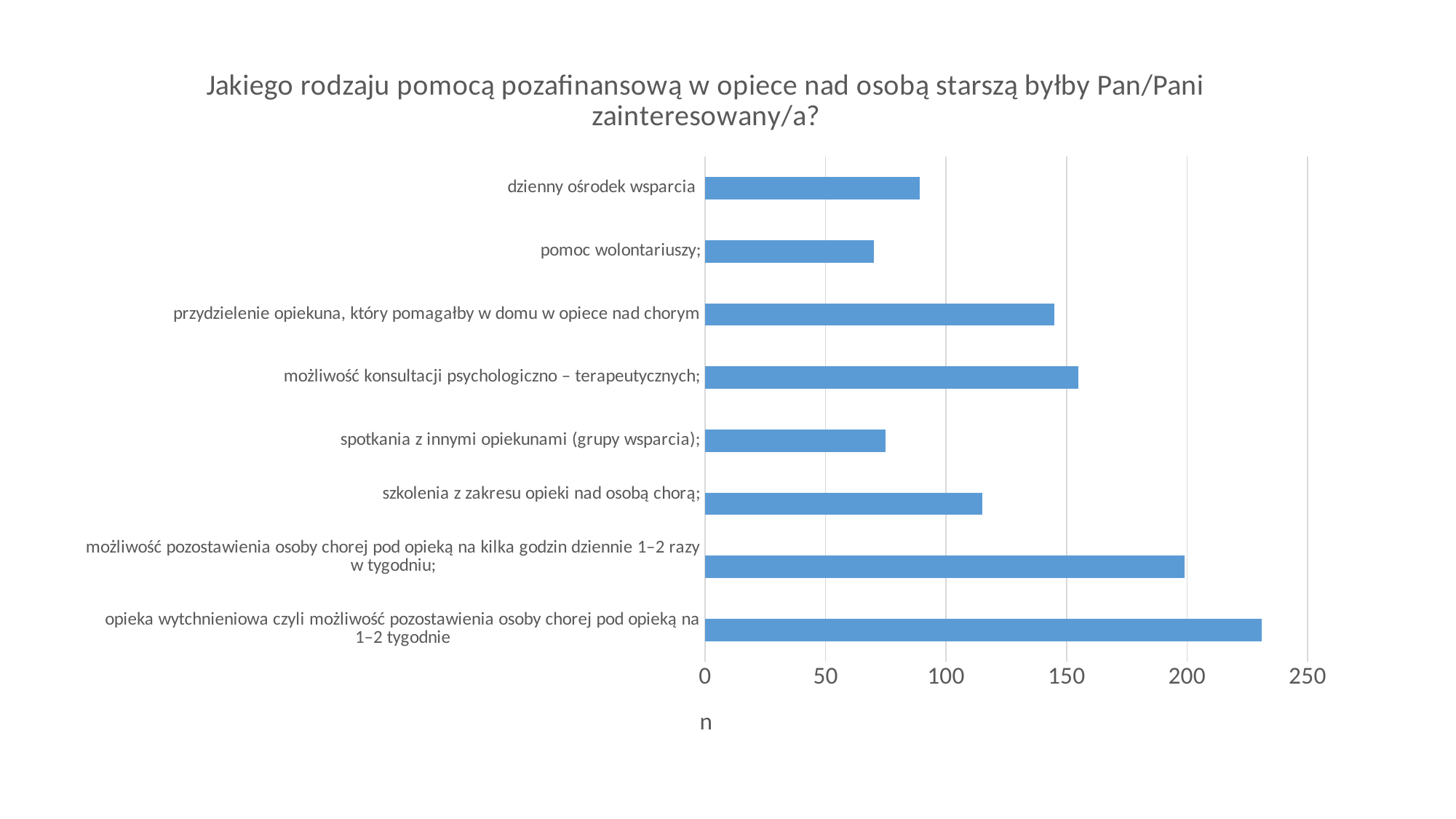
Which has a larger value: 'dzienny ośrodek wsparcia' or 'szkolenia z zakresu opieki nad osobą chorą'? szkolenia z zakresu opieki nad osobą chorą Is the value for 'przydzielenie opiekuna, który pomagałby w domu w opiece nad chorym' greater or less than 100? greater What kind of chart is shown on the slide? bar chart Is the value for 'szkolenia z zakresu opieki nad osobą chorą' greater or less than 100? greater How many categories (types of non-financial help) are shown in the chart? 8 Is the value for 'dzienny ośrodek wsparcia' greater or less than 100? less What is the label of the horizontal axis of the chart? n Which has a larger value: 'spotkania z innymi opiekunami (grupy wsparcia)' or 'możliwość konsultacji psychologiczno – terapeutycznych'? możliwość konsultacji psychologiczno – terapeutycznych Which category has the highest value in the chart? opieka wytchnieniowa czyli możliwość pozostawienia osoby chorej pod opieką na 1–2 tygodnie